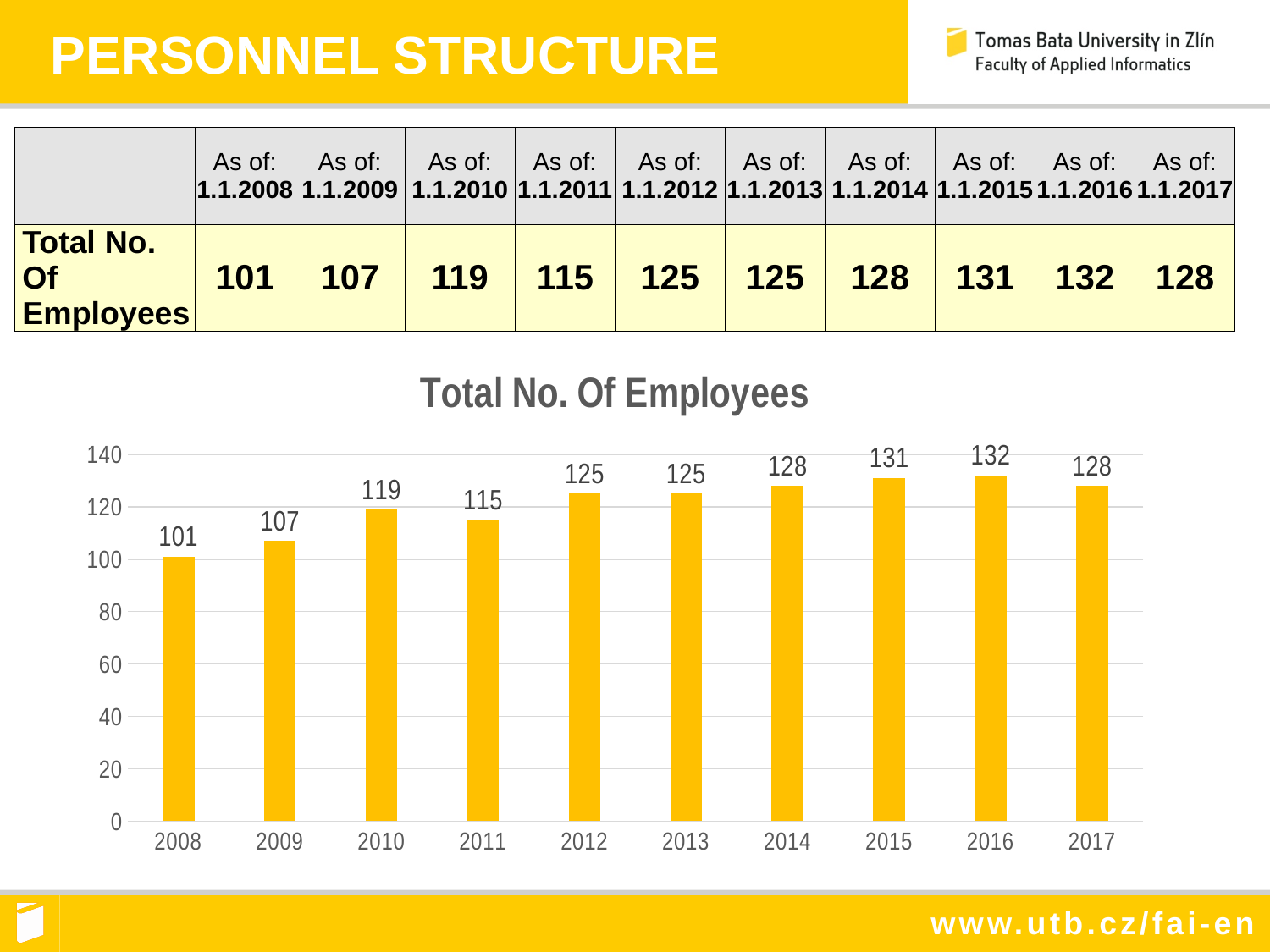
What is the difference between the number of employees in 2016 and in 2008? 31 Do the values generally rise or fall from 2008 to 2016? rise What is the total number of employees in 2010 according to the chart? 119 Is the value for 2009 greater or less than 120? less By how much did the number of employees change from 2016 to 2017? 4 Which year has the highest total number of employees? 2016 What is the value shown for 2015 in the chart? 131 How many years are shown on the x axis of the chart? 10 Which year has more employees, 2011 or 2012? 2012 Which year has the lowest total number of employees? 2008 What kind of chart is shown on the slide? bar chart What is the title of the chart? Total No. Of Employees